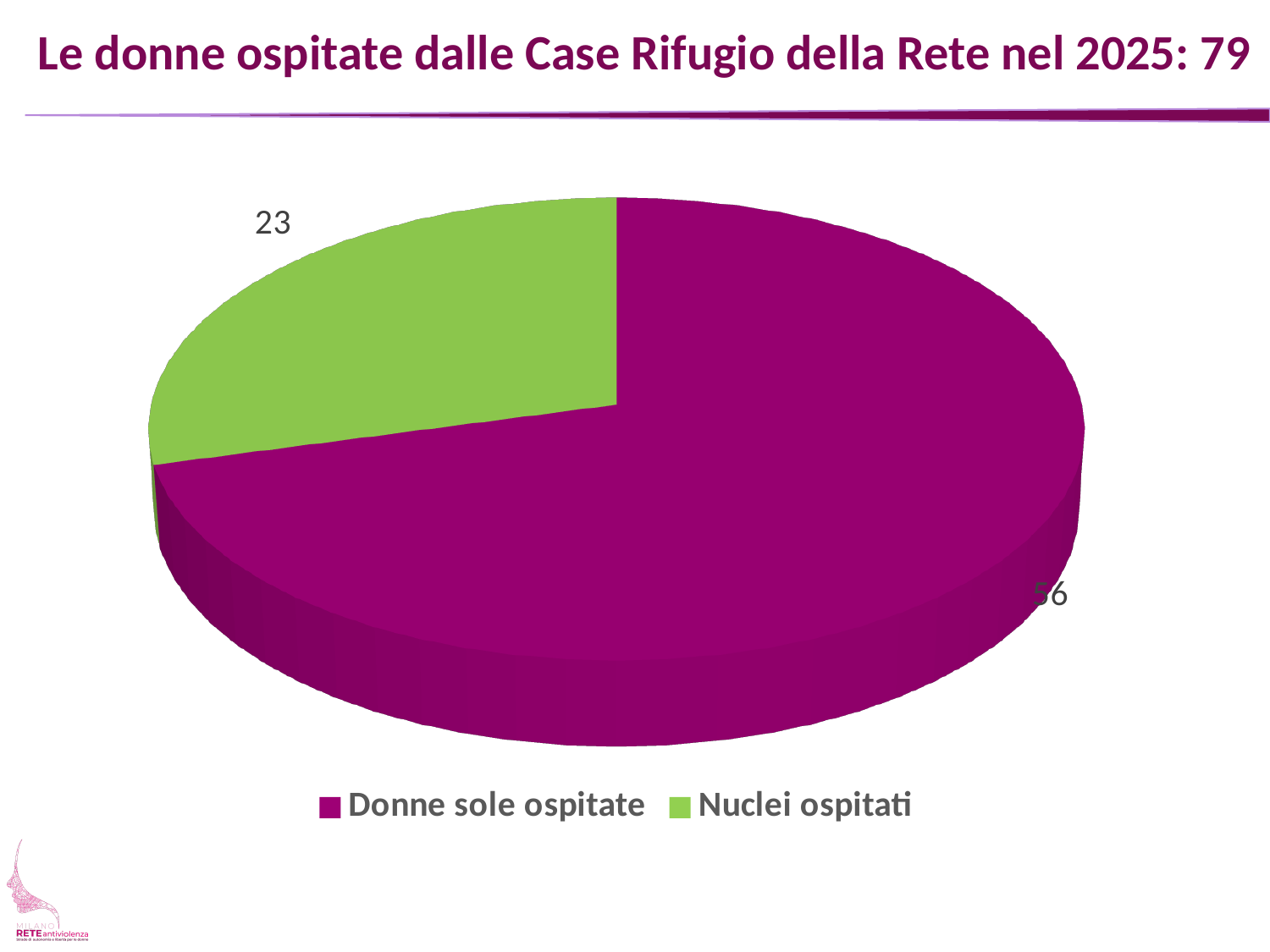
What is the value for Donne sole ospitate? 56 What type of chart is shown on the slide? pie chart Which is larger, the value for Donne sole ospitate or the value for Nuclei ospitati? Donne sole ospitate How many slices does the pie chart have? 2 How many entries does the legend list? 2 What is the difference between the values for Donne sole ospitate and Nuclei ospitati? 33 What share of the pie does Donne sole ospitate represent, as a percentage rounded to the nearest whole number? 71% Which category has the largest slice of the pie? Donne sole ospitate What is the value for Nuclei ospitati? 23 What is the total of the two slices in the pie chart? 79 What colour is the slice for Nuclei ospitati? green Which category has the smallest slice of the pie? Nuclei ospitati